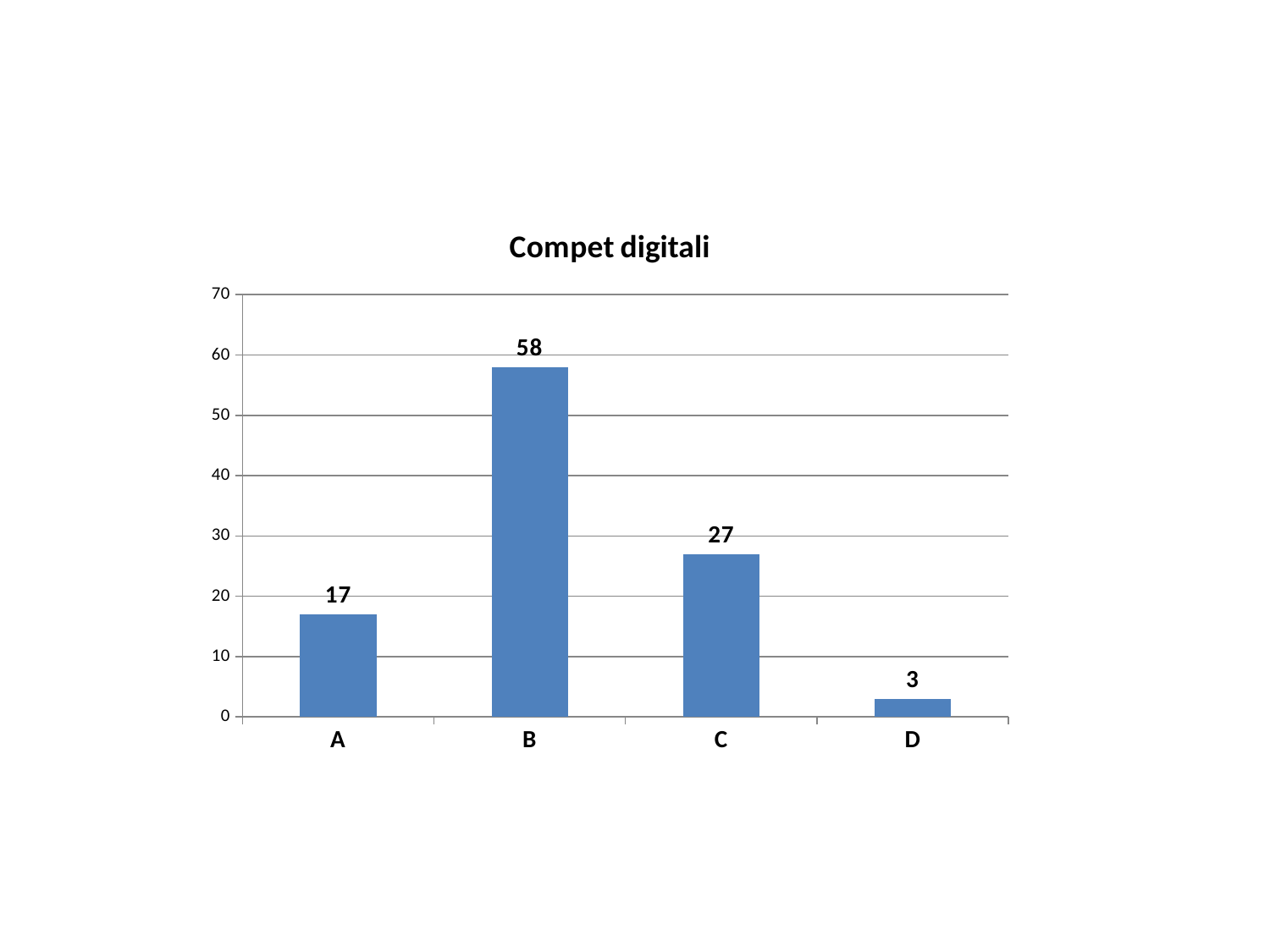
Is the value for C greater or less than 30? less What is the title of the chart? Compet digitali Which is larger, the value for A or the value for C? C What is the value for category B? 58 What is the difference between the values for A and D? 14 How many categories are shown on the x axis? 4 Which category has the highest value? B What is the value for category D? 3 What is the value for category A? 17 What kind of chart is this? bar chart What is the difference between the values for B and C? 31 Which category has the lowest value? D